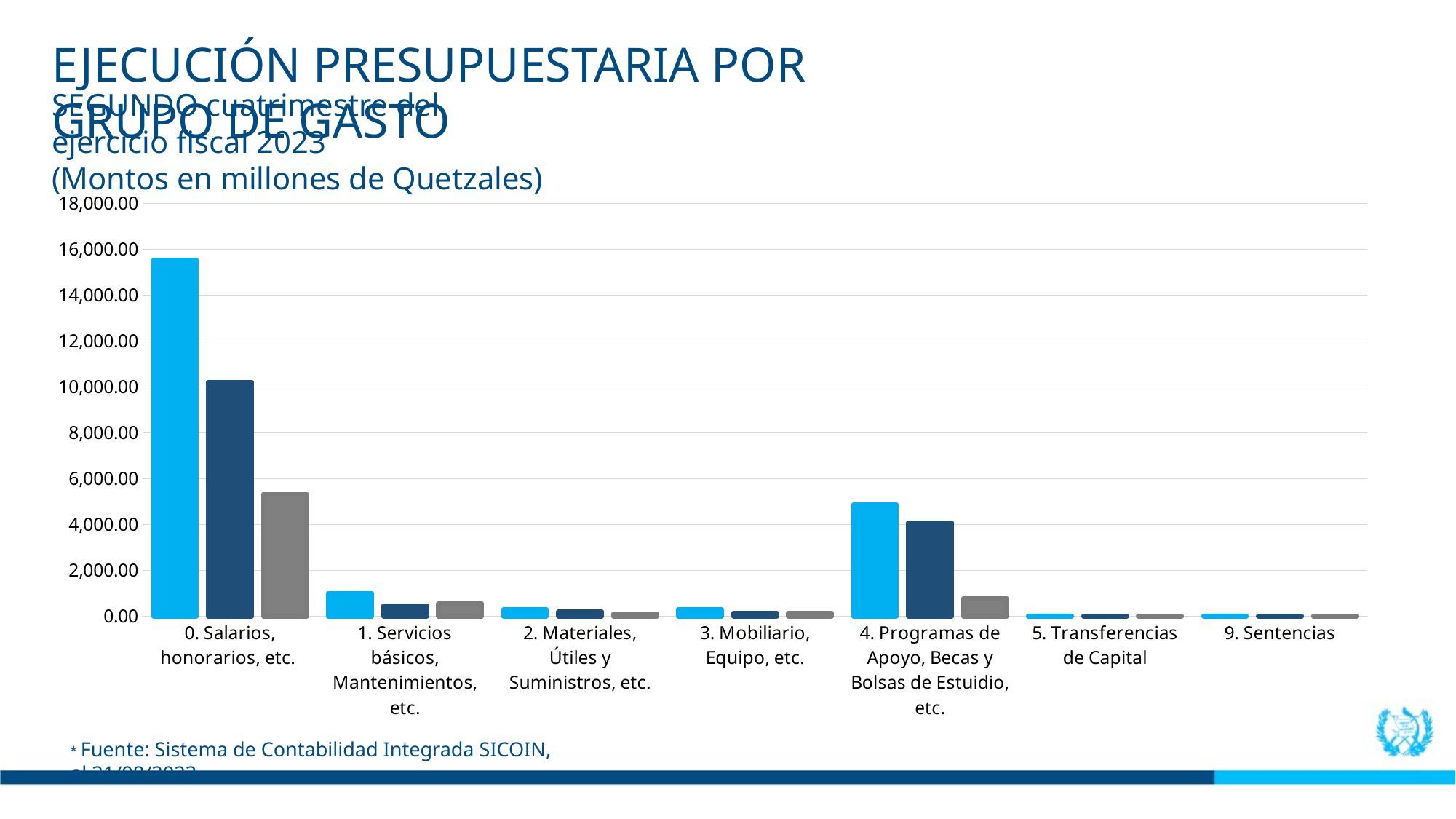
What is the highest value shown on the y axis of the chart? 18,000.00 What kind of chart is shown on the slide? bar chart Is the value of the dark blue bar for '0. Salarios, honorarios, etc.' greater or less than 8,000.00? greater How many expense group categories are shown on the x axis? 7 Is the value of the dark blue bar for '4. Programas de Apoyo, Becas y Bolsas de Estuidio, etc.' greater or less than 6,000.00? less Is the value of the gray bar for '0. Salarios, honorarios, etc.' greater or less than 4,000.00? greater How many bars are plotted for each category? 3 Within '4. Programas de Apoyo, Becas y Bolsas de Estuidio, etc.', which bar is larger: the light blue bar or the gray bar? the light blue bar Which category has the tallest bar in the chart? 0. Salarios, honorarios, etc. Which has the larger light blue bar: '0. Salarios, honorarios, etc.' or '4. Programas de Apoyo, Becas y Bolsas de Estuidio, etc.'? 0. Salarios, honorarios, etc.